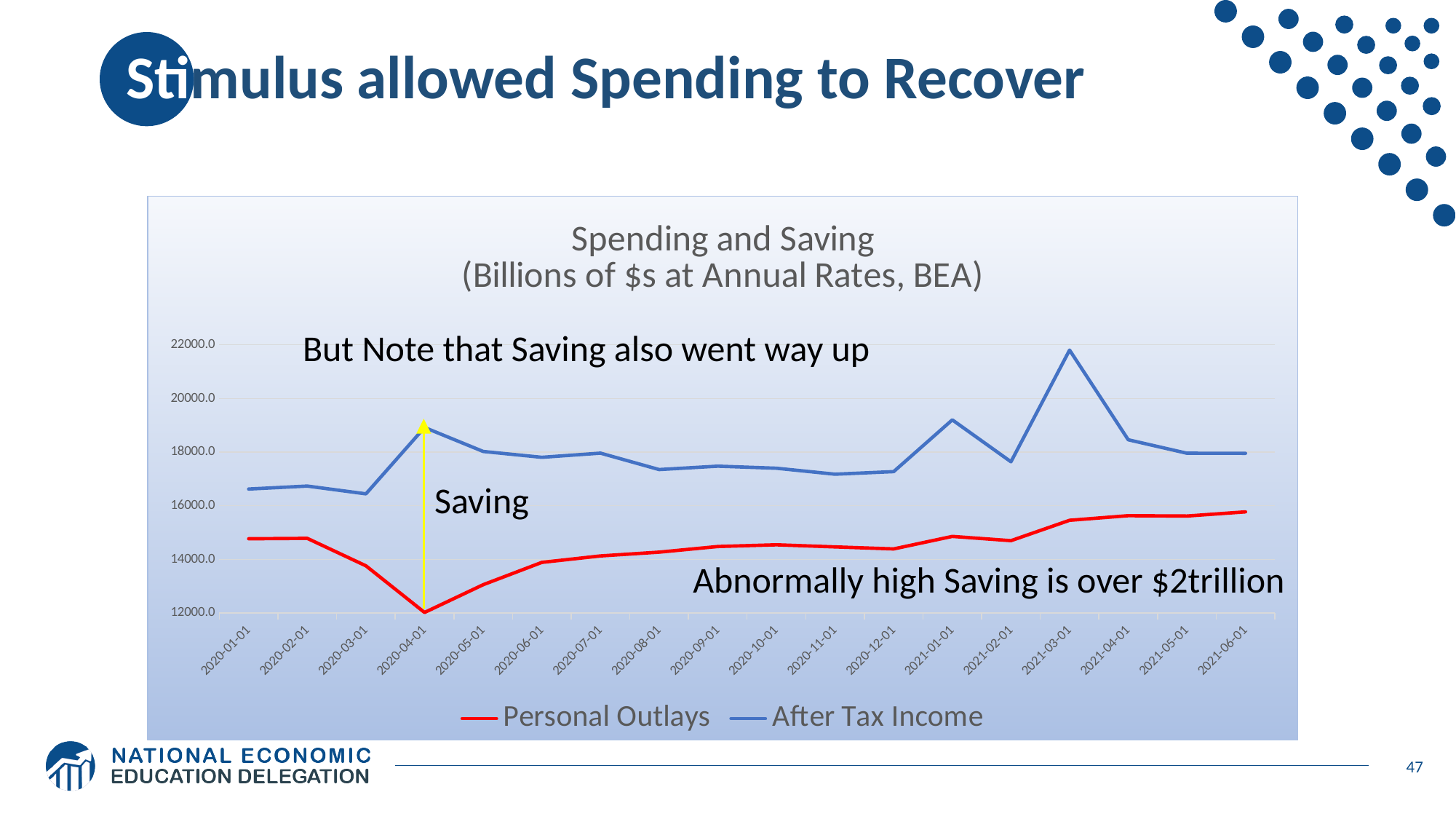
Is the value for Personal Outlays at 2020-01-01 greater or less than 16000.0? less How many dates are shown along the x axis of the chart? 18 At which date do Personal Outlays reach their lowest value? 2020-04-01 What kind of chart is shown on the slide? line chart How many series does the chart's legend list? 2 Is the value for After Tax Income at 2020-01-01 greater or less than 16000.0? greater Which series is drawn in red on the chart? Personal Outlays Is the value for Personal Outlays at 2021-06-01 greater or less than 14000.0? greater At 2020-04-01, which is larger: After Tax Income or Personal Outlays? After Tax Income Do Personal Outlays rise or fall from 2020-04-01 to 2021-06-01? rise At which date does After Tax Income reach its highest value? 2021-03-01